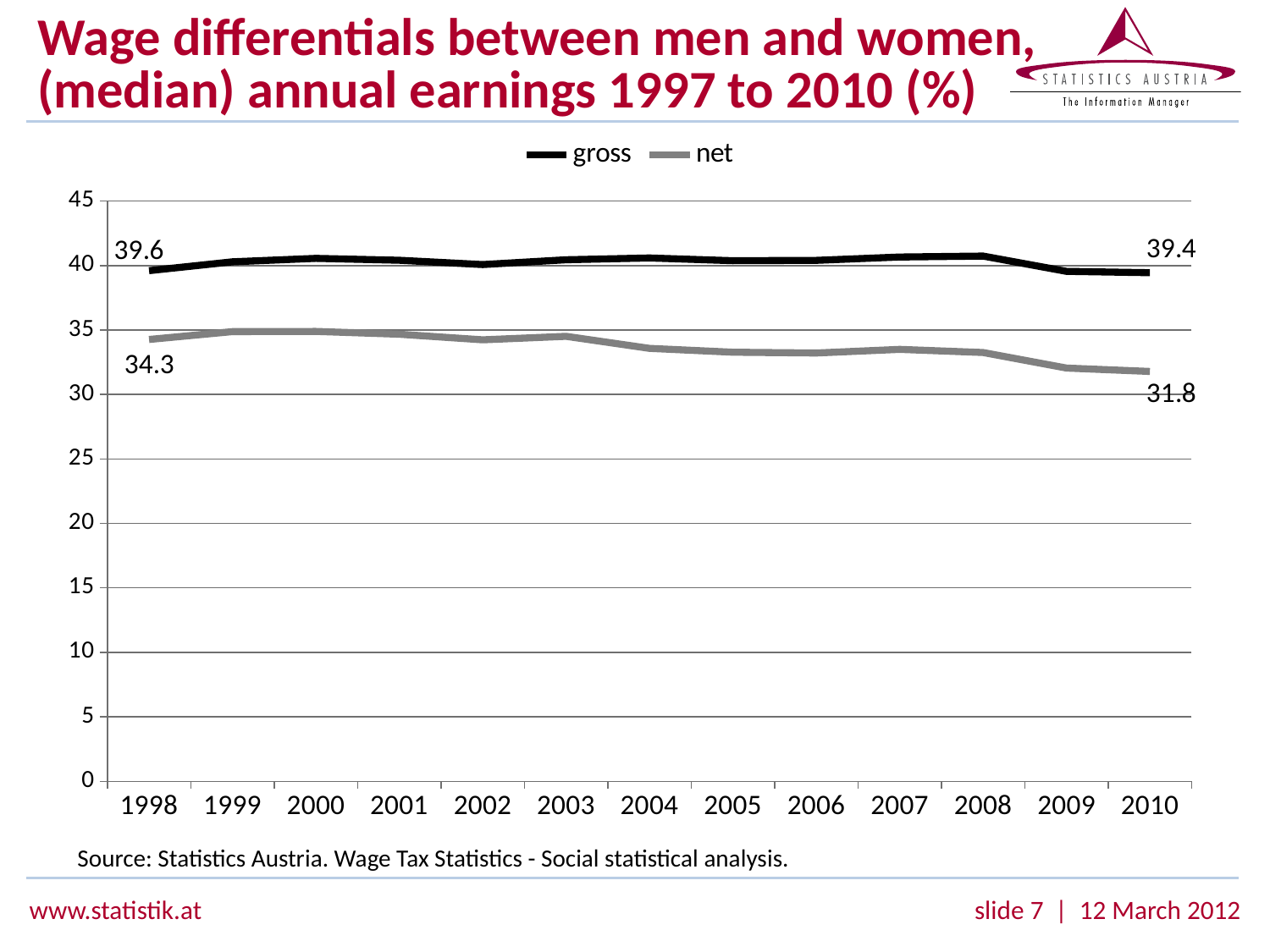
How many series does the legend list? 2 What is the net wage differential in 1998? 34.3 By how much did the net wage differential fall between 1998 and 2010? 2.5 What is the net wage differential in 2010? 31.8 What is the difference between the gross and net wage differentials in 1998? 5.3 How many years are shown on the x axis? 13 Is the net wage differential in 2004 greater or less than 35? less What is the difference between the gross and net wage differentials in 2010? 7.6 What is the gross wage differential in 1998? 39.6 Which series has the higher value in 2005, gross or net? gross What is the gross wage differential in 2010? 39.4 What kind of chart is shown on the slide? line chart